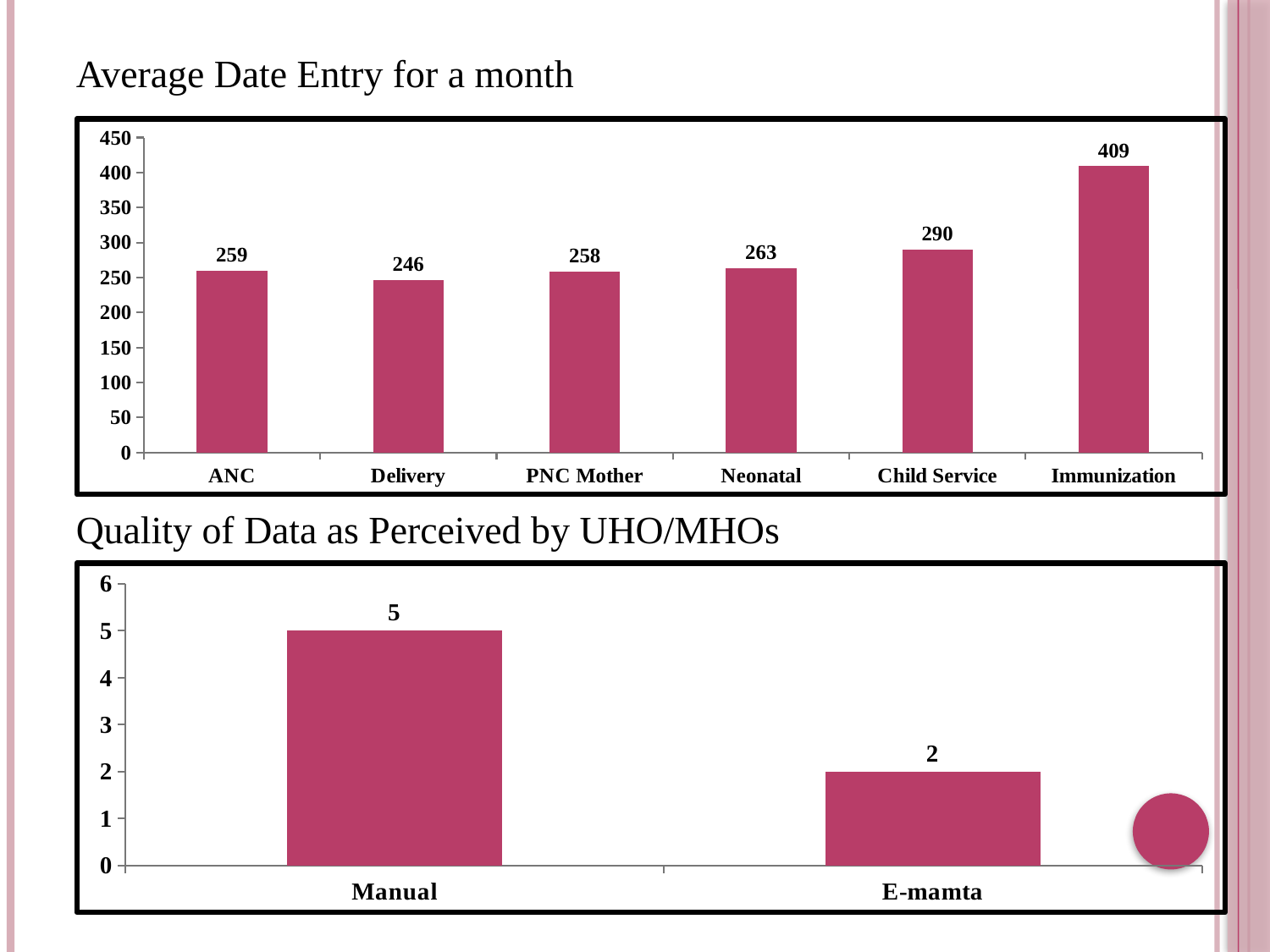
In the 'Average Date Entry for a month' chart, which is larger, Child Service or Neonatal? Child Service What type of chart is the 'Quality of Data as Perceived by UHO/MHOs' chart? Bar chart In the 'Average Date Entry for a month' chart, which category has the lowest value? Delivery In the 'Quality of Data as Perceived by UHO/MHOs' chart, what is the difference between Manual and E-mamta? 3 In the 'Average Date Entry for a month' chart, which category has the highest value? Immunization In the 'Average Date Entry for a month' chart, how many categories are shown? 6 In the 'Quality of Data as Perceived by UHO/MHOs' chart, which category has the higher value? Manual In the 'Average Date Entry for a month' chart, what is the value for Delivery? 246 In the 'Average Date Entry for a month' chart, what is the difference between Immunization and Child Service? 119 In the 'Average Date Entry for a month' chart, what is the value for Immunization? 409 In the 'Quality of Data as Perceived by UHO/MHOs' chart, what is the value for Manual? 5 In the 'Average Date Entry for a month' chart, is the value for Immunization greater or less than 400? greater